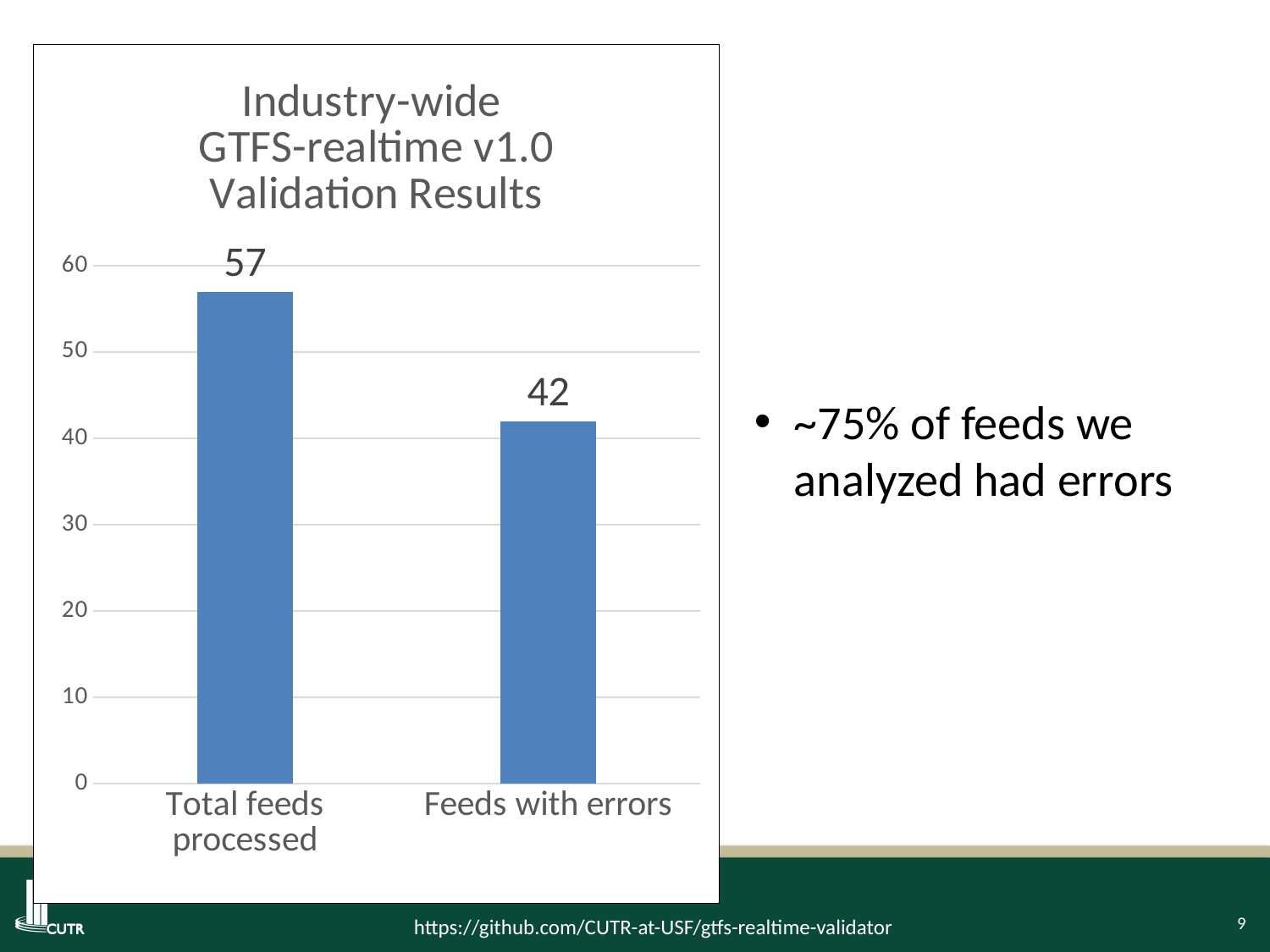
Which category has the lowest value? Feeds with errors What is the difference between Total feeds processed and Feeds with errors? 15 Which is larger, Total feeds processed or Feeds with errors? Total feeds processed What is the value for Total feeds processed? 57 How many categories are shown in the chart? 2 Is the value for Feeds with errors greater or less than 50? less What is the maximum value shown on the vertical axis? 60 What kind of chart is shown on the slide? Bar chart What is the value for Feeds with errors? 42 What is the title of the chart? Industry-wide GTFS-realtime v1.0 Validation Results Which category has the highest value? Total feeds processed Is the value for Total feeds processed greater or less than 50? greater